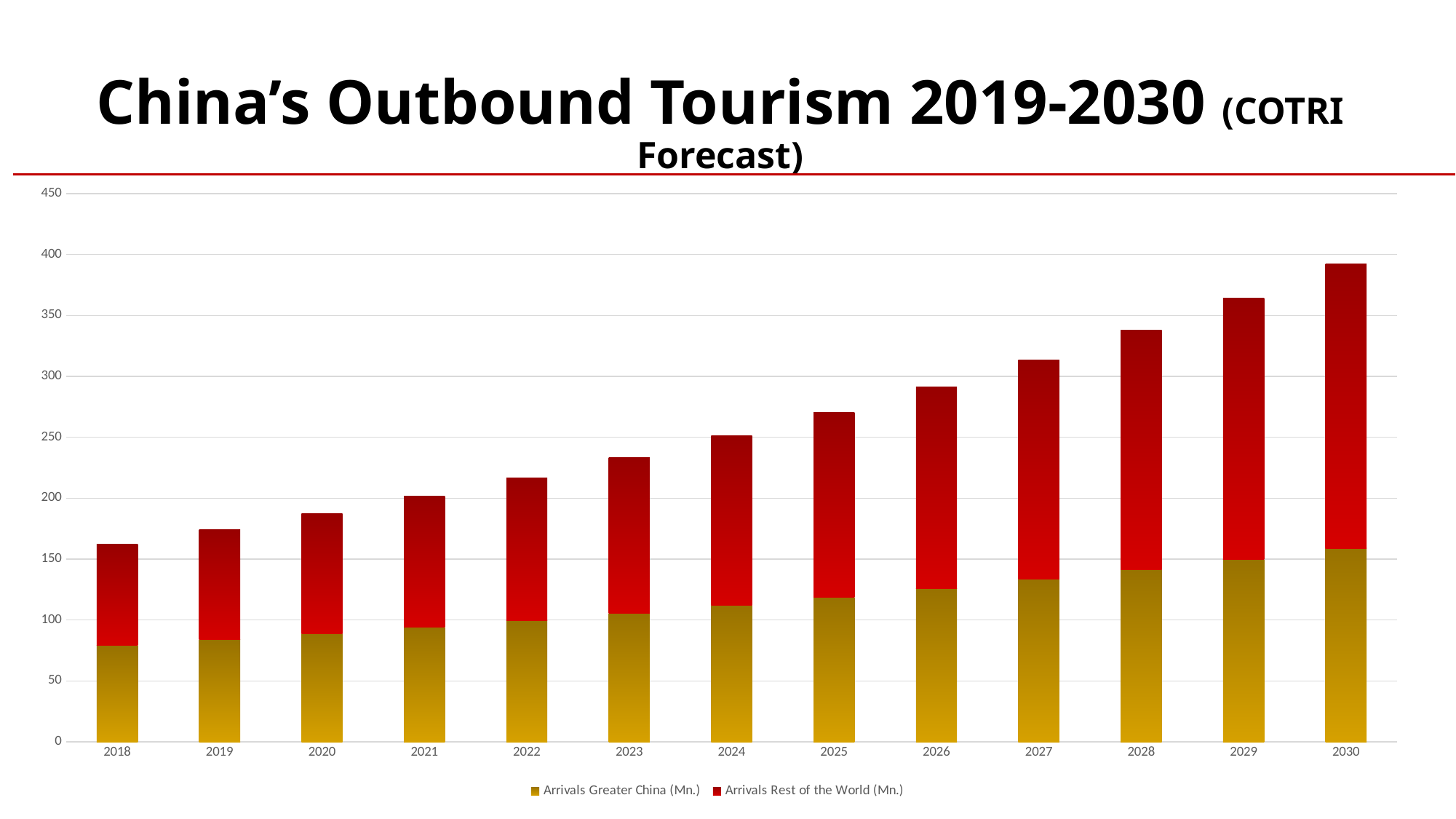
Is the Arrivals Greater China (Mn.) value for 2018 greater or less than 100? less Is the total stacked bar for 2030 greater or less than 350? greater Which year has the lowest total stacked bar? 2018 How many years are shown along the x axis of the chart? 13 Which series is shown in red in the chart? Arrivals Rest of the World (Mn.) Do the total arrivals rise or fall from 2018 to 2030? Rise Which is larger, the total stacked bar for 2018 or for 2030? 2030 Is the Arrivals Greater China (Mn.) value for 2030 greater or less than 150? greater What kind of chart is shown on the slide? Stacked bar chart Which year has the highest total stacked bar? 2030 How many series does the chart's legend list? 2